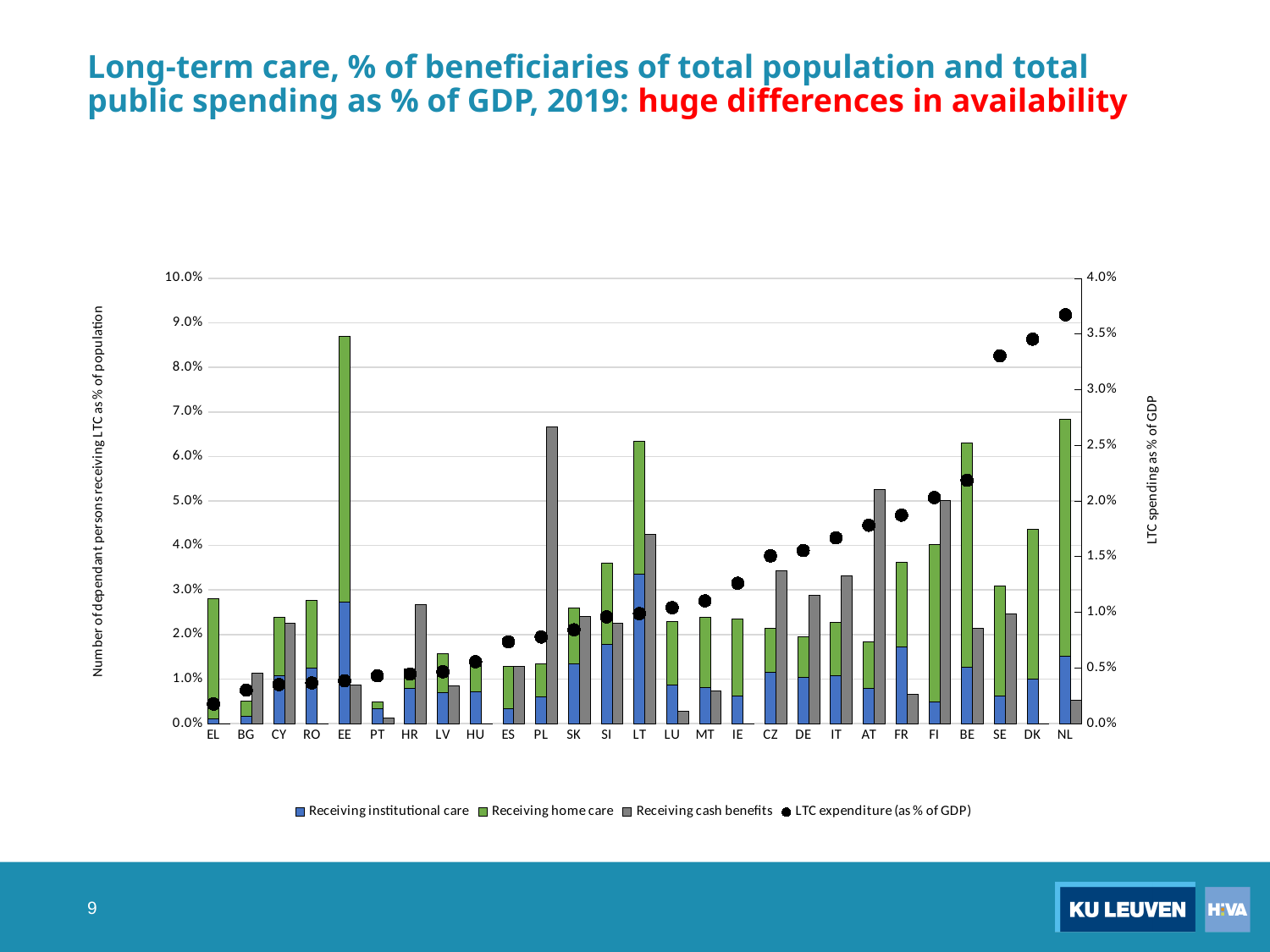
Do the LTC expenditure (as % of GDP) markers generally rise or fall from left to right across the countries? rise Is the LTC expenditure marker for NL greater or less than 3.5% of GDP? greater Which country has the tallest stacked bar for persons receiving institutional and home care? EE How many countries are shown on the x axis of the chart? 27 Is the stacked bar for EE (institutional plus home care) greater or less than 8.0%? greater Which country has the highest LTC expenditure (as % of GDP) marker? NL What colour represents 'Receiving home care' in the chart? green Which country has the tallest bar for 'Receiving cash benefits'? PL Is the 'Receiving cash benefits' bar for PL greater or less than 6.0%? greater How many series does the legend list? 4 Which is taller: the 'Receiving cash benefits' bar for PL or for AT? PL Which country has the lowest LTC expenditure (as % of GDP) marker? EL